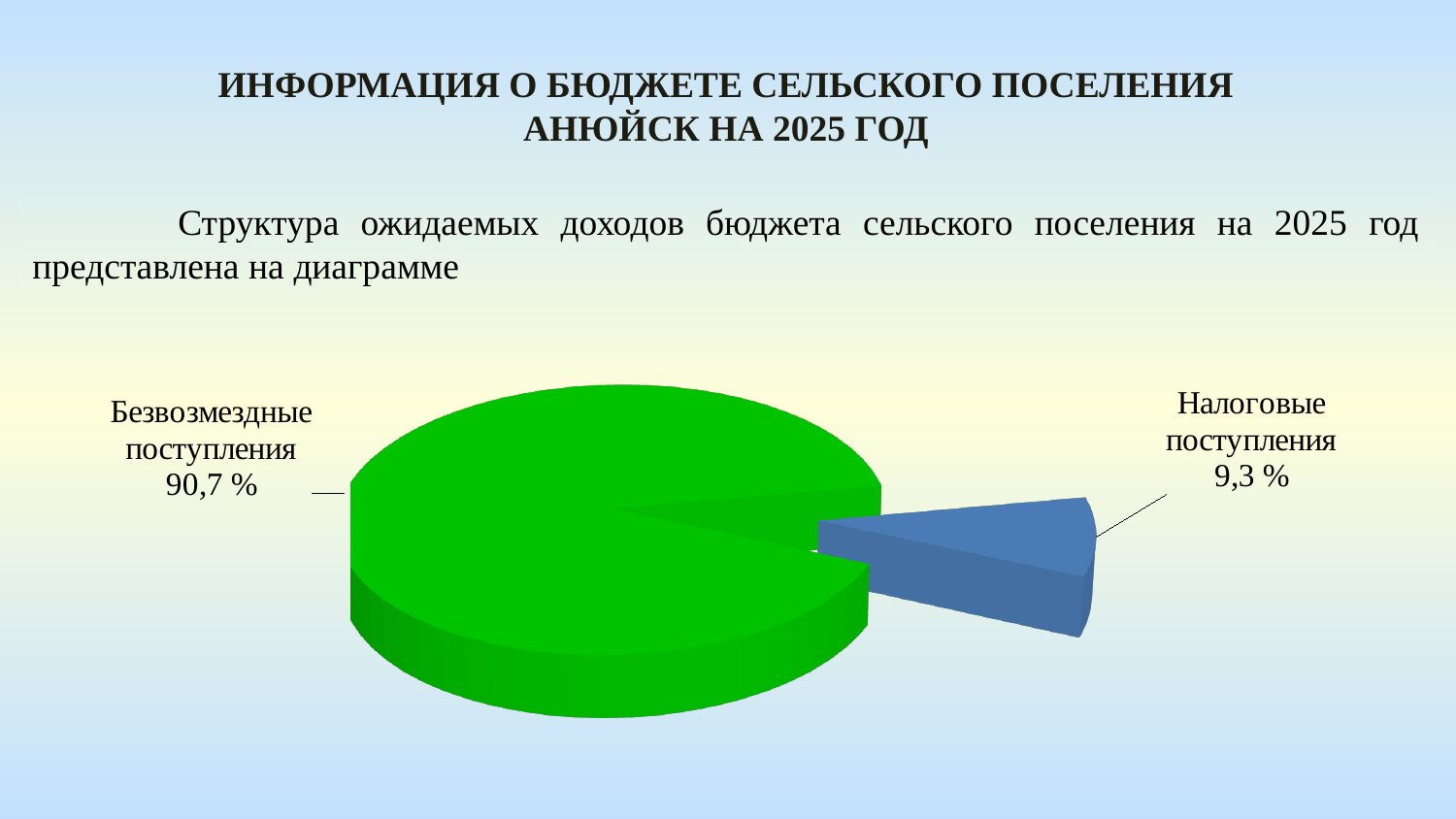
What share of the pie does "Безвозмездные поступления" have? 90,7 % What is the difference in percentage points between "Безвозмездные поступления" and "Налоговые поступления"? 81,4 % How many slices does the pie chart have? 2 What colour is the slice for "Безвозмездные поступления"? green What kind of chart is shown on the slide? pie chart Which is larger, "Безвозмездные поступления" or "Налоговые поступления"? Безвозмездные поступления Which slice of the pie is the largest? Безвозмездные поступления What share of the pie does "Налоговые поступления" have? 9,3 % What colour is the slice for "Налоговые поступления"? blue Which slice of the pie is the smallest? Налоговые поступления